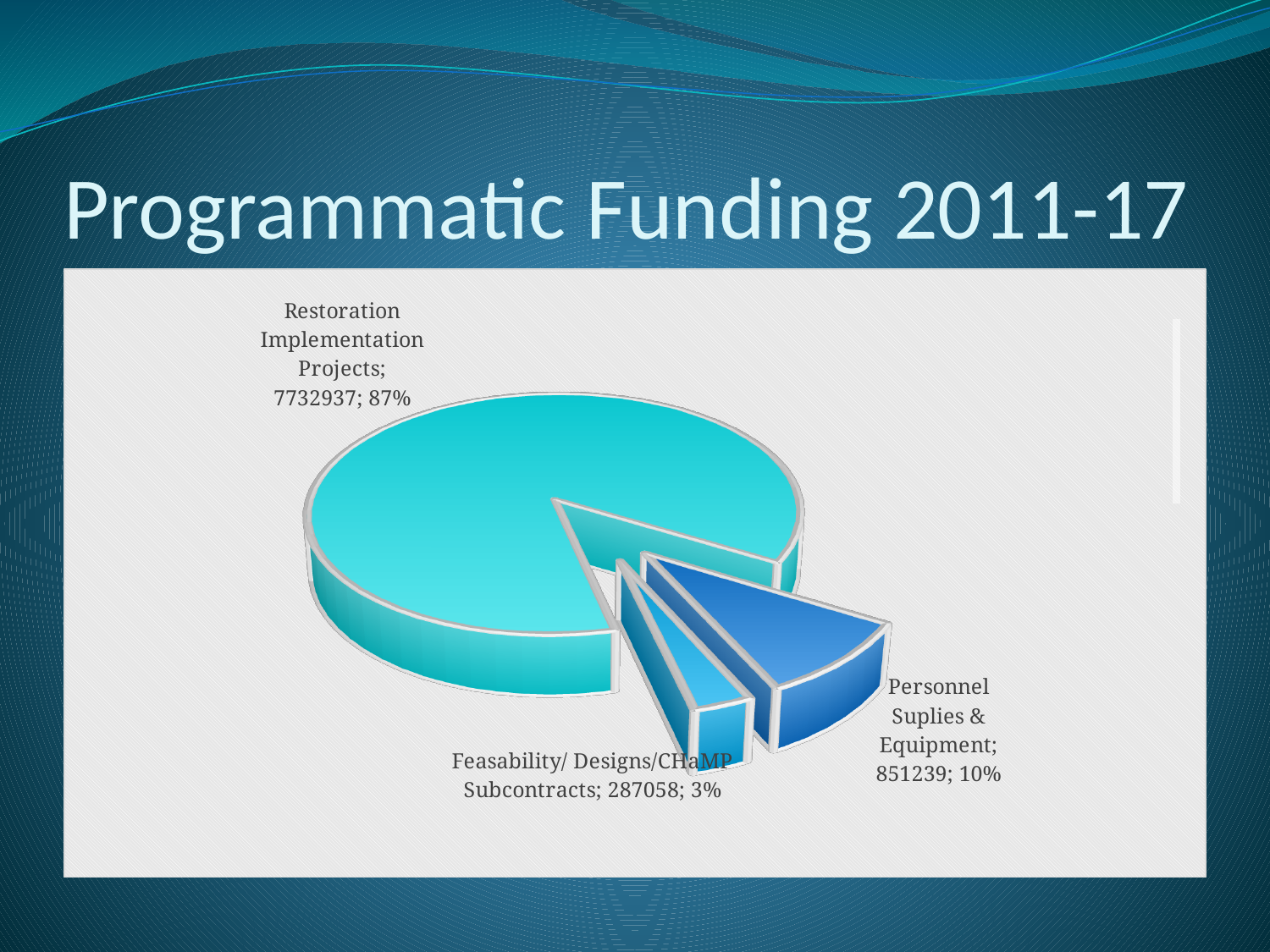
What type of chart is shown on the slide? Pie chart What share of the pie does Restoration Implementation Projects represent? 87% What share of the pie does Personnel Suplies & Equipment represent? 10% Which is larger, Personnel Suplies & Equipment or Feasability/ Designs/CHaMP Subcontracts? Personnel Suplies & Equipment Which category has the smallest slice of the pie? Feasability/ Designs/CHaMP Subcontracts What is the value for Restoration Implementation Projects? 7732937 What is the title of the slide containing the pie chart? Programmatic Funding 2011-17 Which category has the largest slice of the pie? Restoration Implementation Projects What is the value for Feasability/ Designs/CHaMP Subcontracts? 287058 What is the value for Personnel Suplies & Equipment? 851239 What is the difference between the values for Personnel Suplies & Equipment and Feasability/ Designs/CHaMP Subcontracts? 564181 How many slices does the pie chart have? 3